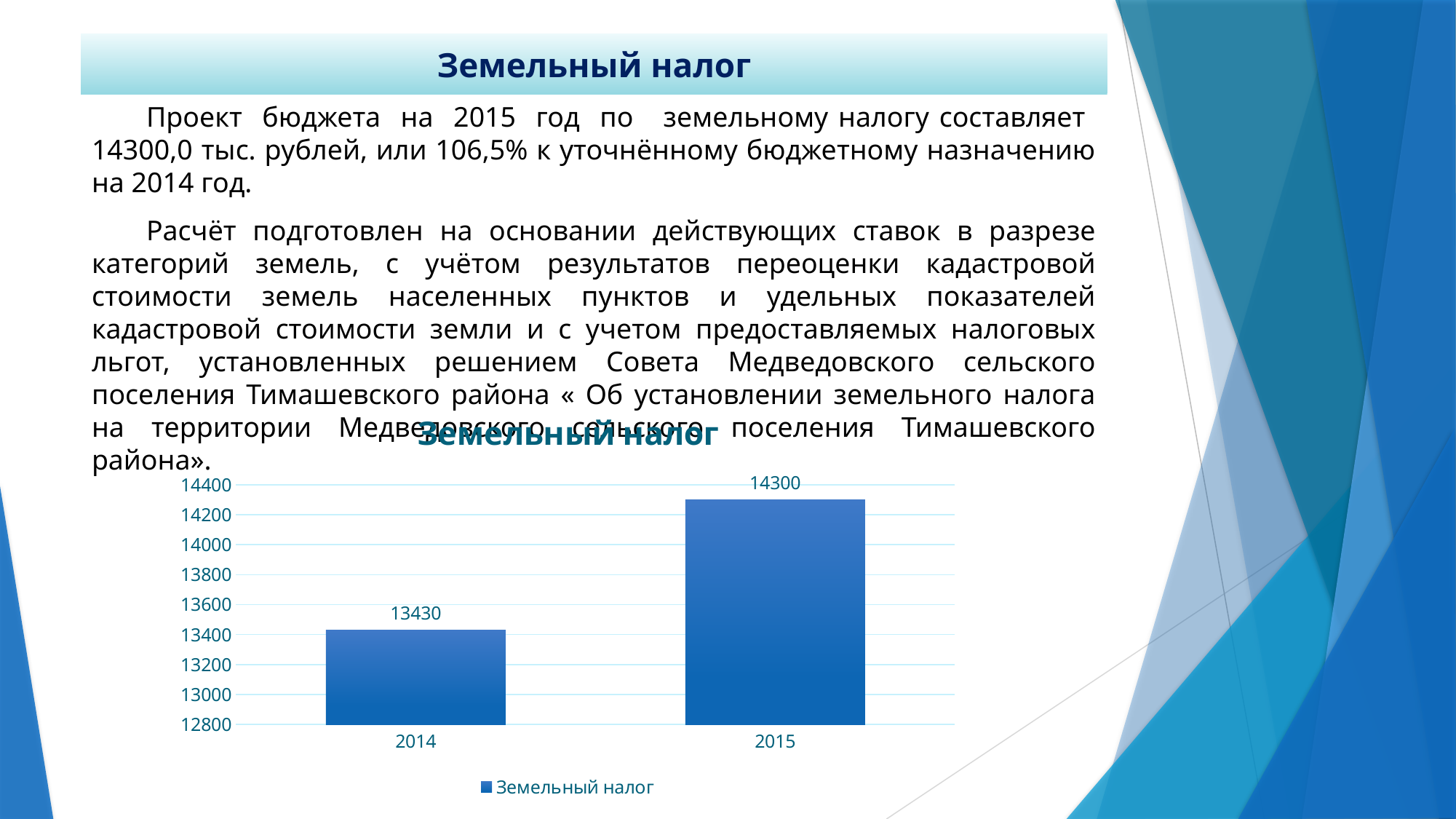
What kind of chart is shown on the slide? bar chart Do the values rise or fall from 2014 to 2015? rise How many series does the chart legend list? 1 What is the value for 2014 in the chart? 13430 What is the value for 2015 in the chart? 14300 Which year has the lowest value in the chart? 2014 Which year has the highest value in the chart? 2015 Is the value for 2015 greater or less than 14000? greater Is the value for 2014 greater or less than 13600? less Which is larger in the chart, the value for 2014 or the value for 2015? 2015 What is the difference between the 2015 and 2014 values in the chart? 870 How many categories are shown on the x axis of the chart? 2